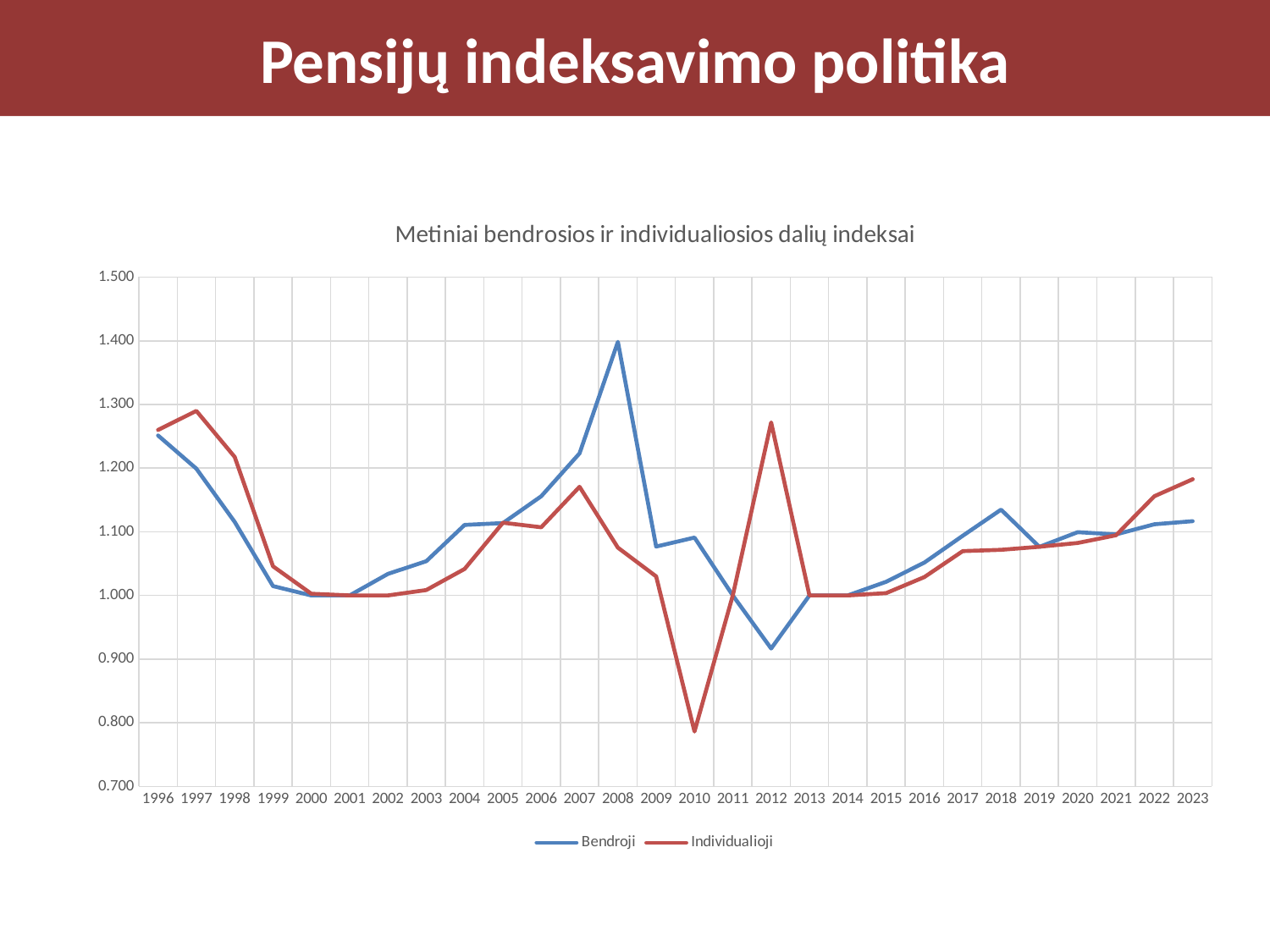
How many series does the legend list? 2 What is the title of the chart? Metiniai bendrosios ir individualiosios dalių indeksai Which series is drawn in red? Individualioji Is the Bendroji value for 2008 greater or less than 1.300? greater In 2012, which series has the larger value, Bendroji or Individualioji? Individualioji In which year does the Bendroji series reach its lowest value? 2012 Is the Individualioji value for 2010 greater or less than 0.900? less Does the Bendroji series rise or fall from 1996 to 2000? Fall What kind of chart is shown on the slide? Line chart How many years are plotted along the x axis? 28 In which year does the Individualioji series reach its lowest value? 2010 In which year does the Bendroji series reach its highest value? 2008